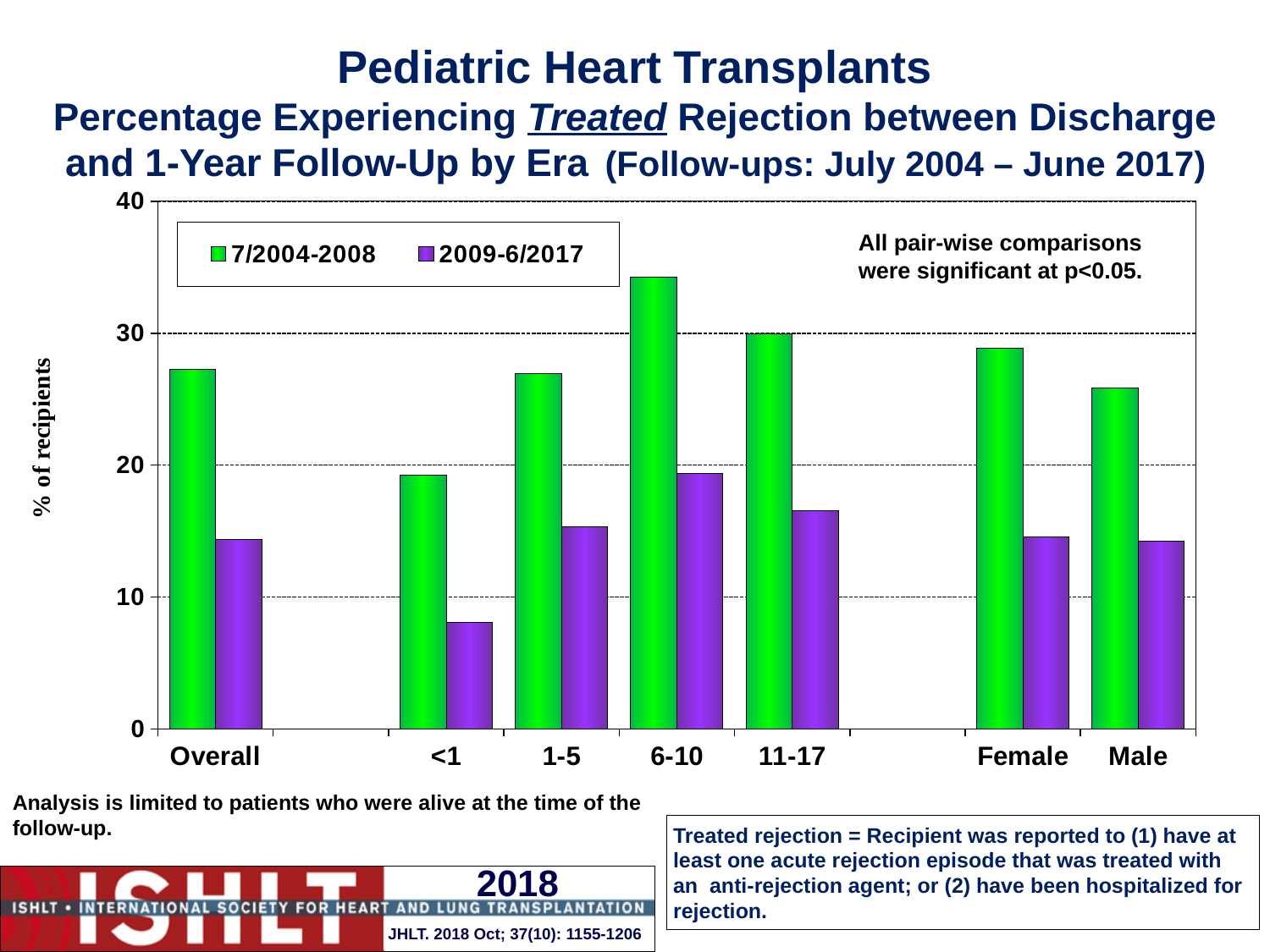
Is the 7/2004-2008 value for Overall greater or less than 30? less Which category has the lowest value for the 7/2004-2008 series? <1 Which category has the highest value for the 7/2004-2008 series? 6-10 Which category has the lowest value for the 2009-6/2017 series? <1 How many categories are shown along the x axis? 7 Is the 2009-6/2017 value for <1 greater or less than 10? less Is the 7/2004-2008 value for 6-10 greater or less than 30? greater How many series does the legend list? 2 Which category has the highest value for the 2009-6/2017 series? 6-10 Which colour represents the 2009-6/2017 series in the legend? purple What kind of chart is shown on the slide? bar chart For the Female category, which series has the larger value, 7/2004-2008 or 2009-6/2017? 7/2004-2008